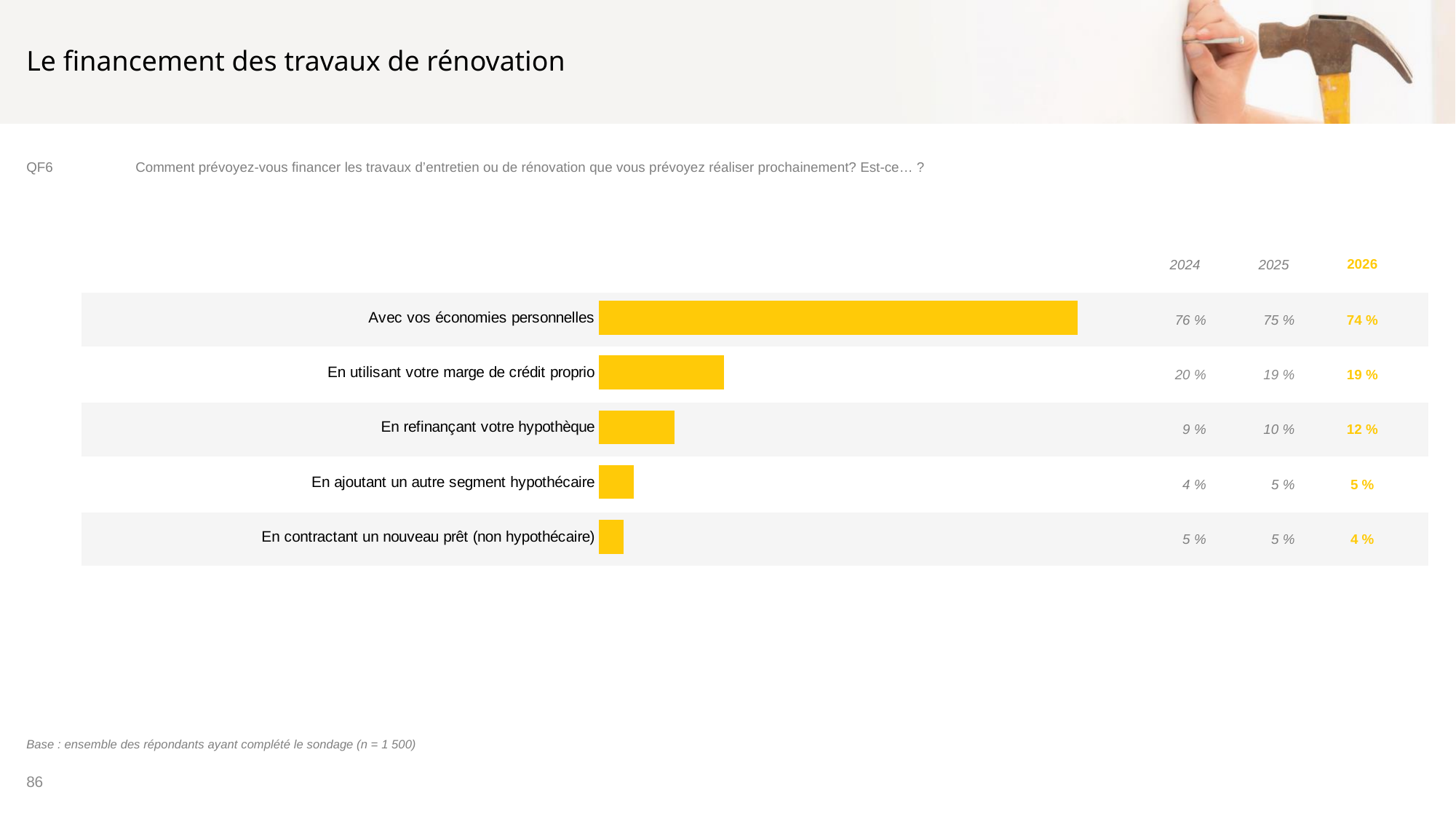
What is the 2025 value for "En utilisant votre marge de crédit proprio"? 19 % What is the 2024 value for "En refinançant votre hypothèque"? 9 % How many years of data are shown in the table next to the chart? 3 Which category has the highest 2026 value? Avec vos économies personnelles What is the 2026 value for "Avec vos économies personnelles"? 74 % Which category has the lowest 2026 value? En contractant un nouveau prêt (non hypothécaire) Did the value for "Avec vos économies personnelles" rise or fall from 2024 to 2026? Fall What colour are the bars in the chart? Yellow What kind of chart is shown on the slide? Bar chart How many categories are shown in the chart? 5 What is the difference between the 2026 values for "Avec vos économies personnelles" and "En utilisant votre marge de crédit proprio"? 55 % Which is larger in 2026: "En refinançant votre hypothèque" or "En ajoutant un autre segment hypothécaire"? En refinançant votre hypothèque